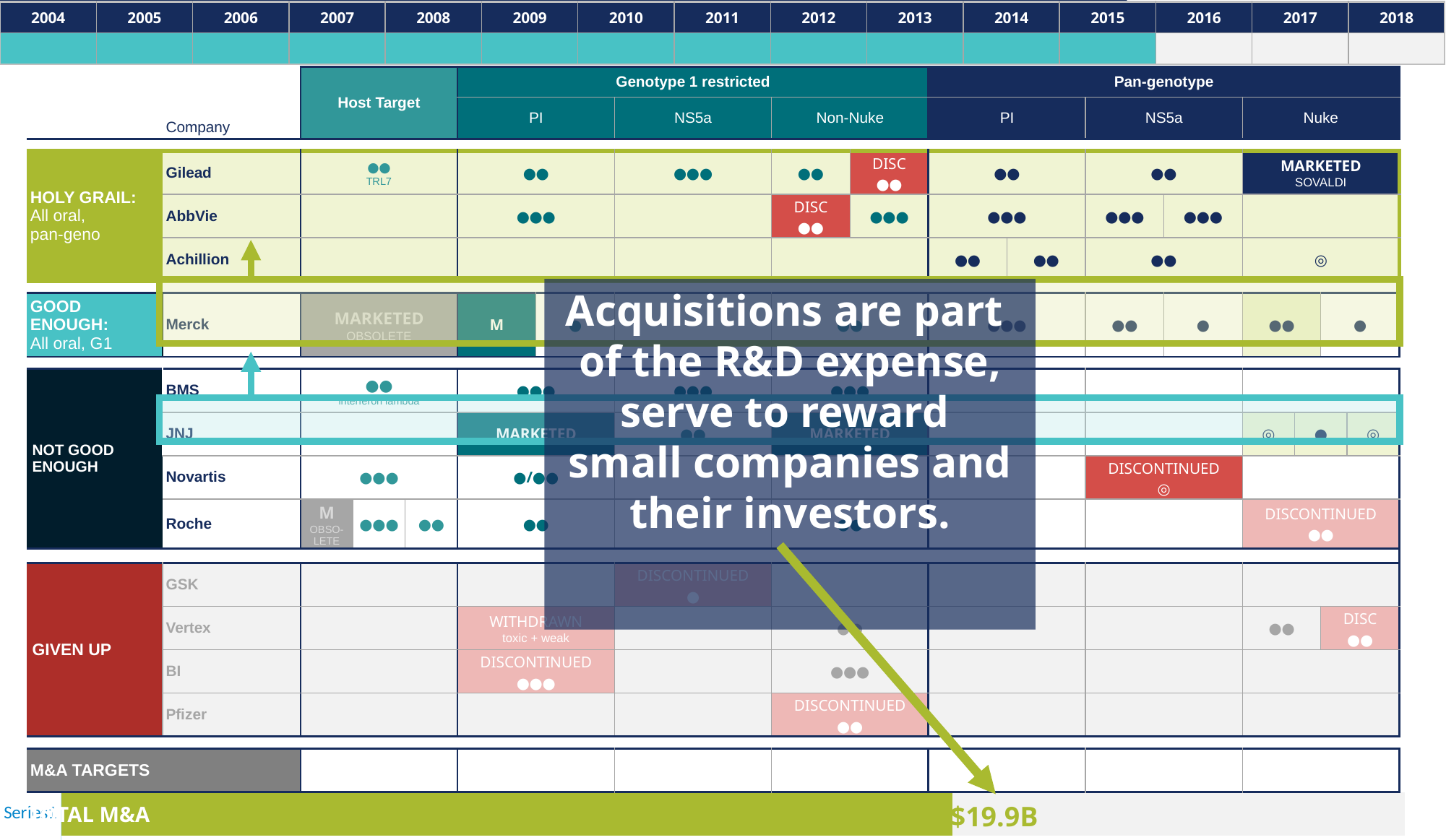
What value is printed on the TOTAL M&A bar at the bottom of the slide? $19.9B How many bars does the TOTAL M&A bar chart at the bottom of the slide show? 1 What colour is the TOTAL M&A bar at the bottom of the slide? green What kind of chart is the TOTAL M&A graphic at the bottom of the slide? bar chart What is the label of the single bar in the bar chart at the bottom of the slide? TOTAL M&A